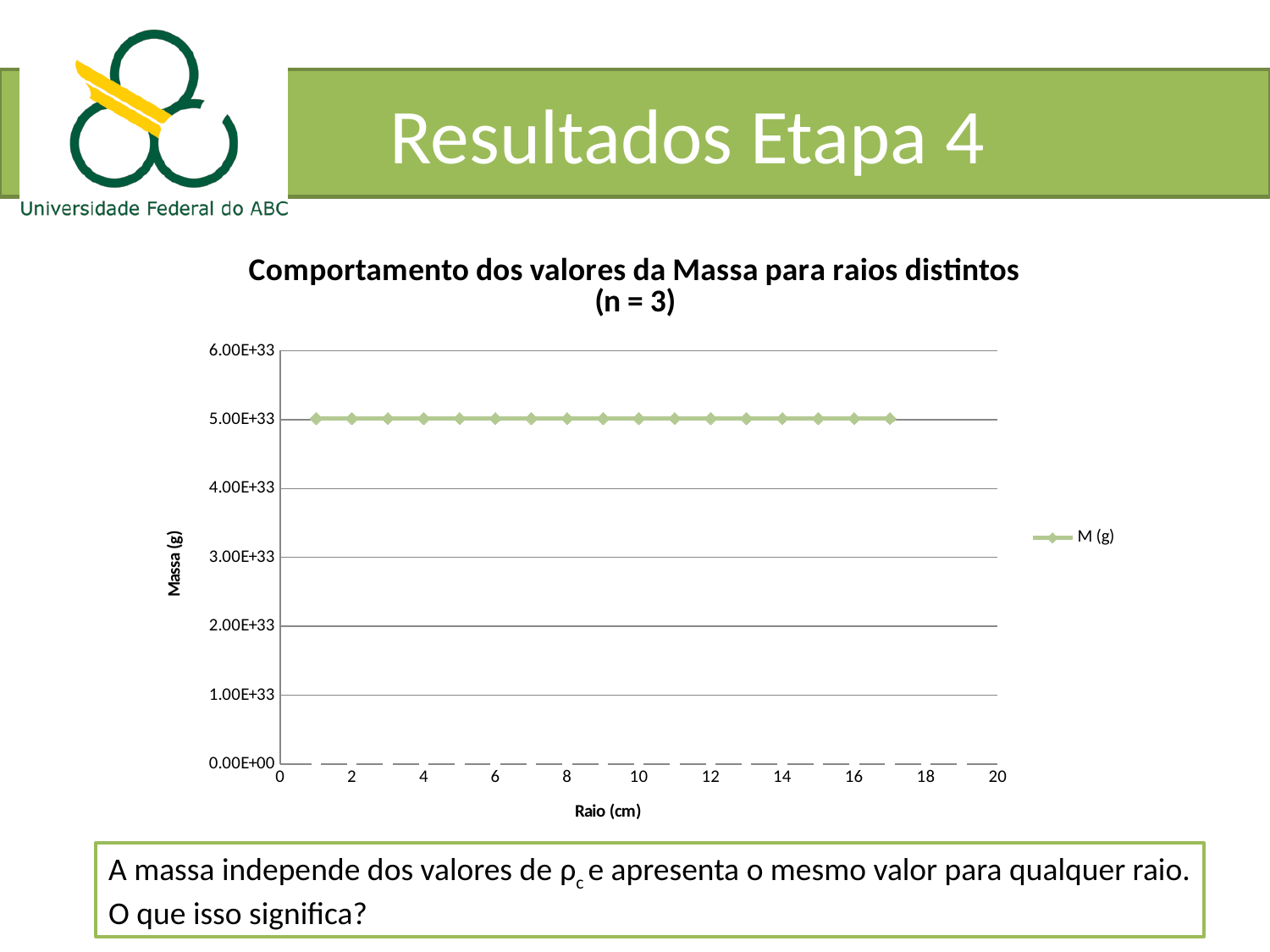
What is the label of the horizontal axis? Raio (cm) How many series does the legend list? 1 Is the value of M (g) at Raio = 1 cm greater or less than 6.00E+33? less What is the name of the series shown in the legend? M (g) What is the largest value shown on the vertical axis? 6.00E+33 Do the values of M (g) rise, fall or stay constant as Raio (cm) increases? stay constant How many data points are plotted on the line? 17 Is the value of M (g) at Raio = 10 cm greater or less than 4.00E+33? greater Is the value of M (g) at Raio = 17 cm greater or less than 3.00E+33? greater What kind of chart is shown on the slide? line chart